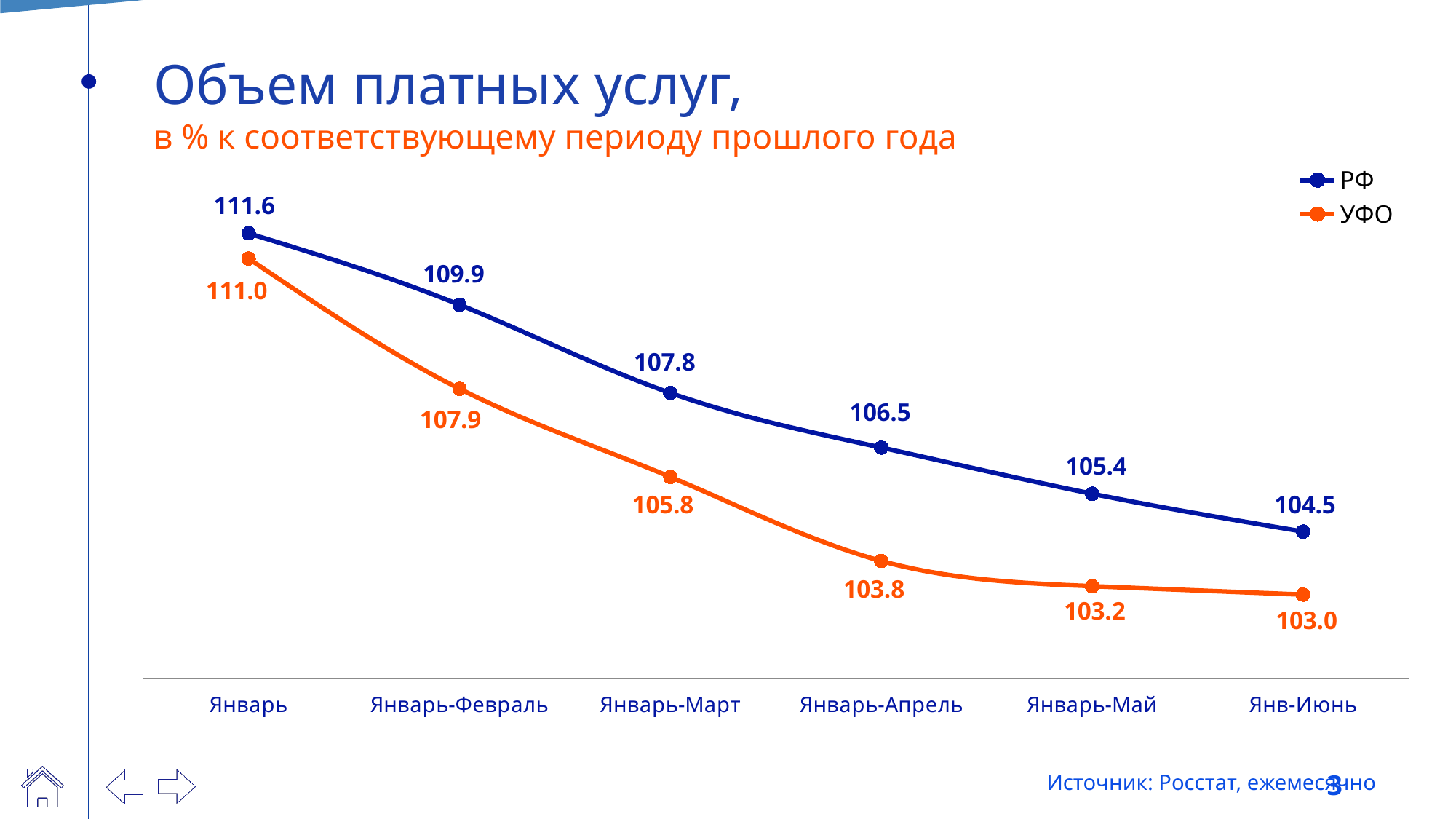
Which is larger in Январь-Апрель, РФ or УФО? РФ What is the value for УФО in Янв-Июнь? 103.0 What kind of chart is shown on the slide? Line chart How many series does the legend list? 2 Which period has the lowest value for УФО? Янв-Июнь What is the difference between the РФ values for Январь and Январь-Февраль? 1.7 What is the value for УФО in Январь-Апрель? 103.8 Which period has the highest value for РФ? Январь What is the difference between РФ and УФО in Янв-Июнь? 1.5 What is the value for РФ in Январь-Март? 107.8 How many periods are shown on the x axis? 6 What is the value for РФ in Январь-Май? 105.4